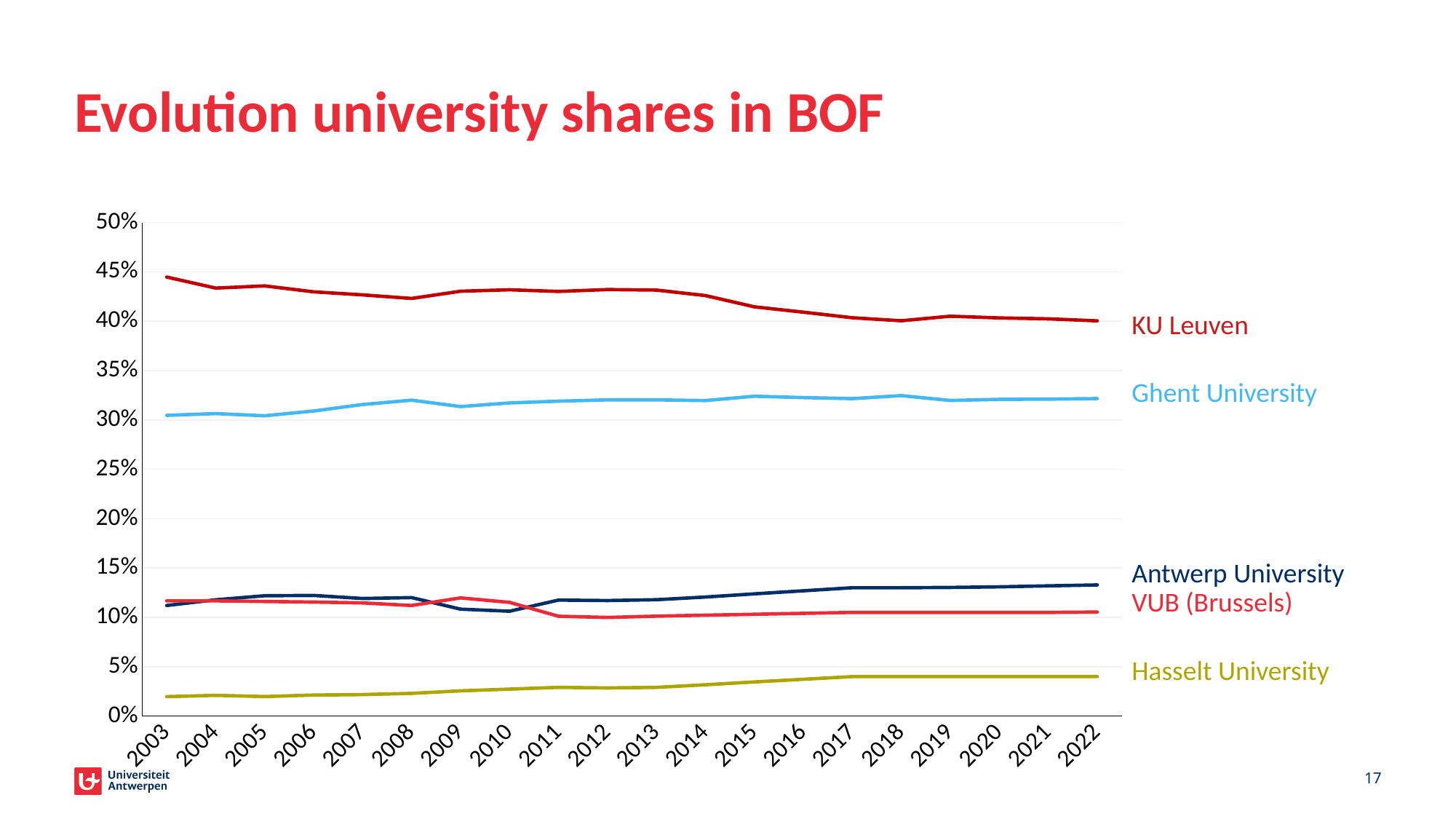
Is the share of Hasselt University in 2022 greater or less than 5%? less Does the share of KU Leuven rise or fall from 2003 to 2022? fall Which university has the lowest share in BOF across the whole period? Hasselt University What kind of chart is shown on the slide? line chart How many years are shown along the x axis? 20 What is the title of the chart? Evolution university shares in BOF In 2022, which has the larger share: Antwerp University or VUB (Brussels)? Antwerp University How many universities (series) are plotted in the chart? 5 Is the share of Ghent University in 2022 greater or less than 30%? greater Does the share of Hasselt University rise or fall from 2003 to 2022? rise Which university has the highest share in BOF across the whole period? KU Leuven Is the share of KU Leuven in 2003 greater or less than 40%? greater